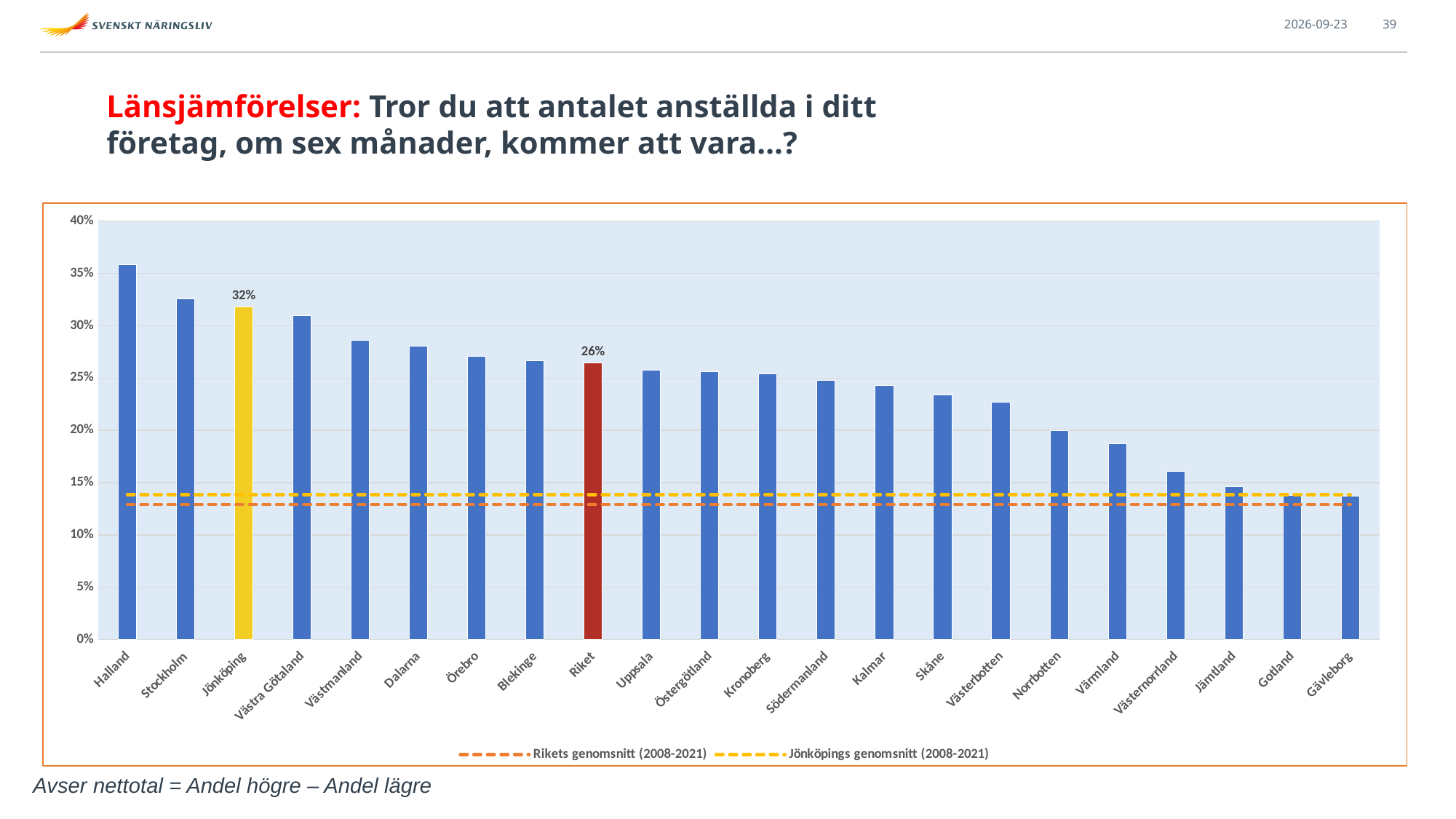
Which is larger, the value for Halland or the value for Stockholm? Halland What is the value shown for Riket? 26% Which category has the highest bar? Halland How many dashed reference lines does the legend list? 2 How many bars (categories) are shown in the chart? 22 What is the difference between the values for Jönköping and Riket? 6% Is the value for Stockholm greater or less than 30%? greater Do the bar values rise or fall from left to right along the x axis? Fall What is the value shown for Jönköping? 32% What colour is the bar for Jönköping? Yellow What kind of chart is shown on the slide? Bar chart Is the value for Värmland greater or less than 20%? less